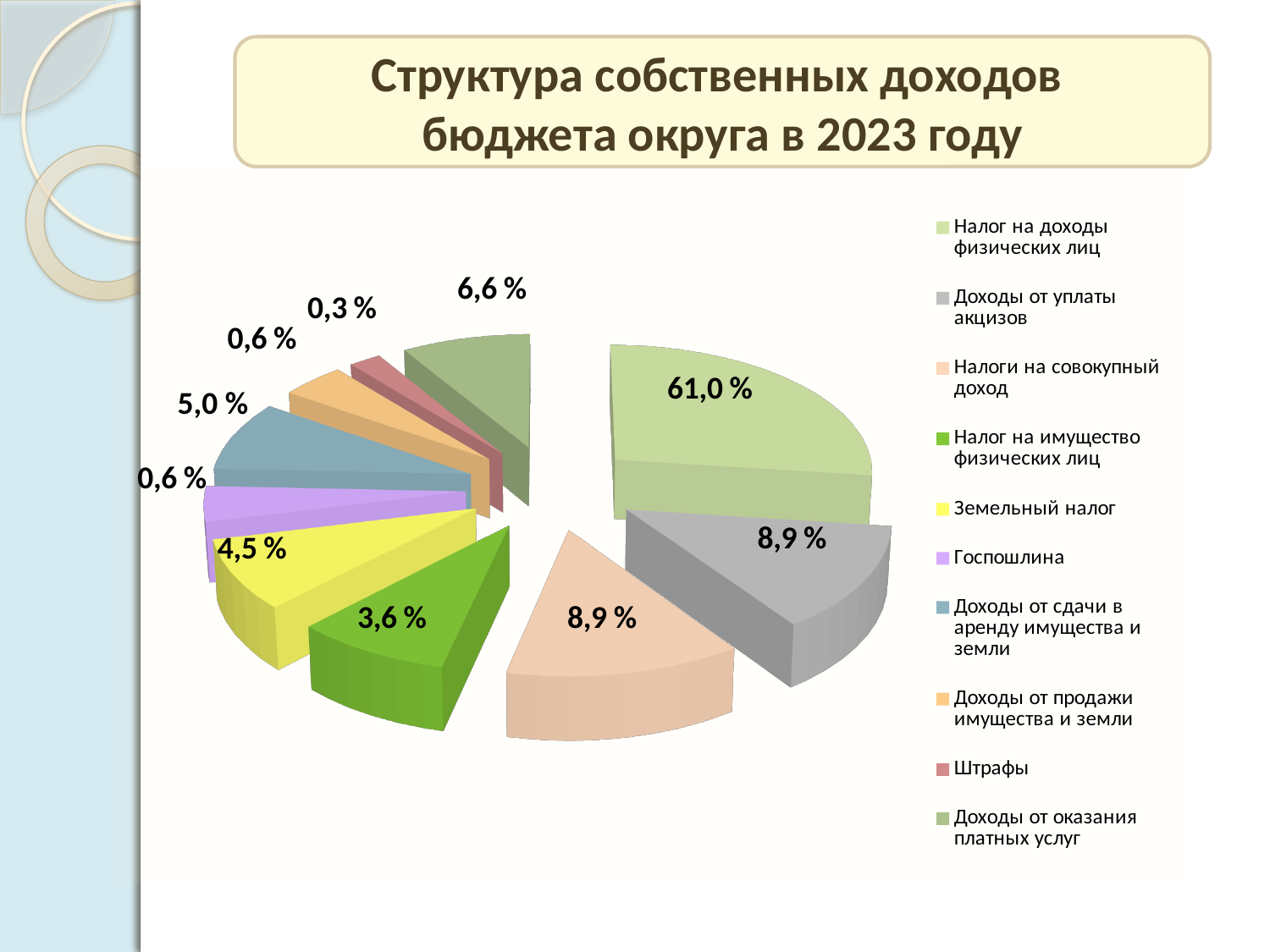
Which category has the smallest share of the pie? Штрафы What is the title of the chart on the slide? Структура собственных доходов бюджета округа в 2023 году Which category has the largest share of the pie? Налог на доходы физических лиц What is the share of Доходы от оказания платных услуг? 6,6 % What is the share of Налог на имущество физических лиц? 3,6 % What is the share of Доходы от сдачи в аренду имущества и земли? 5,0 % How many categories does the legend list? 10 What kind of chart is shown on the slide? pie chart What is the share of Земельный налог? 4,5 % Which is larger: the share of Земельный налог or the share of Налог на имущество физических лиц? Земельный налог What is the share of Налог на доходы физических лиц in the pie chart? 61,0 % What is the difference between the shares of Налог на доходы физических лиц and Доходы от уплаты акцизов? 52,1 %